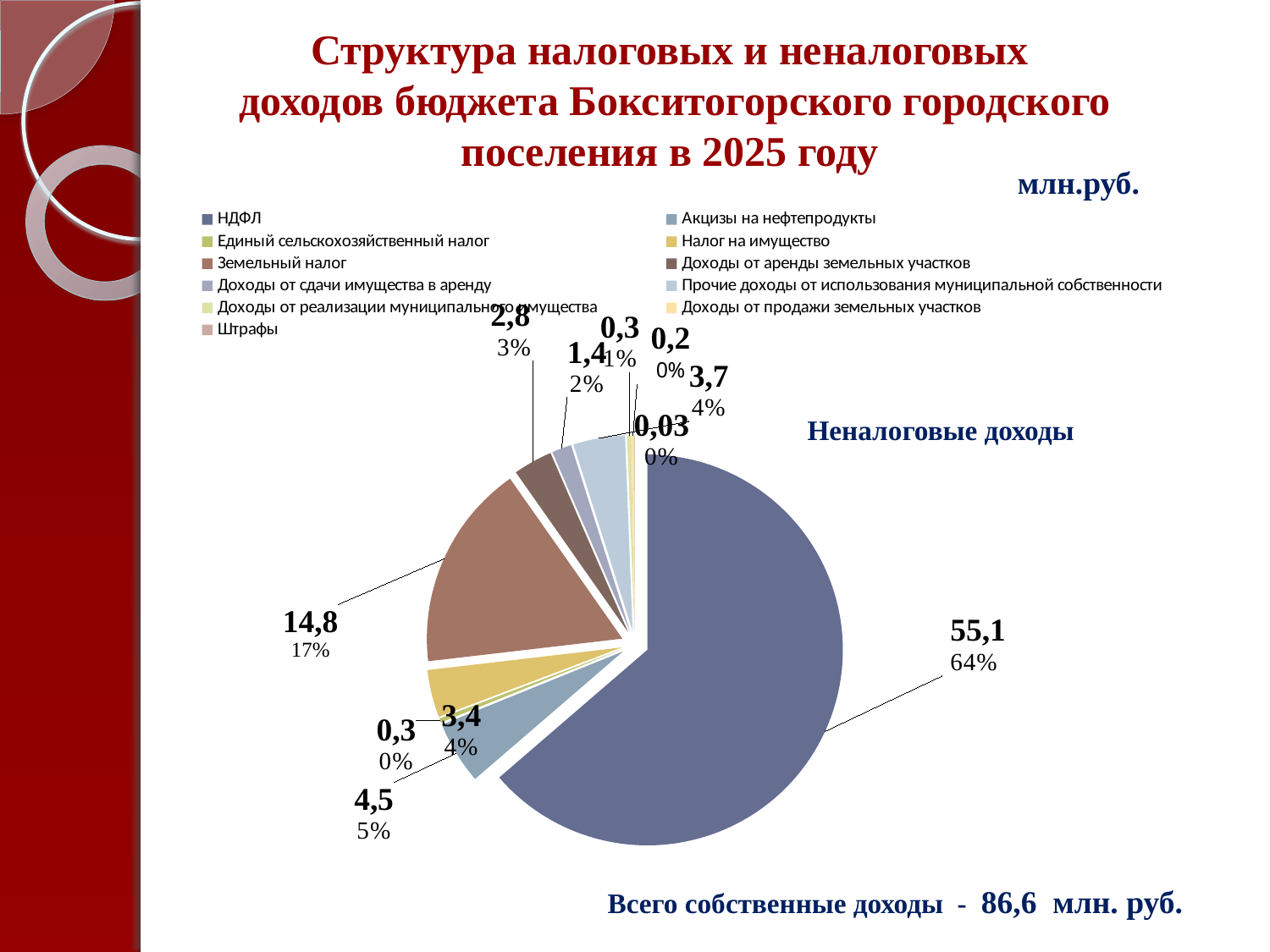
What share of the pie does НДФЛ account for? 64% What is the value shown for НДФЛ? 55,1 What share of the pie does Земельный налог account for? 17% How many entries does the chart legend list? 11 Which is larger: the slice labelled 14,8 or the slice labelled 4,5? 14,8 What kind of chart is shown on the slide? pie chart What unit of measurement is indicated for the chart values? млн.руб. What is the difference between the values for НДФЛ (55,1) and Земельный налог (14,8)? 40,3 What total of own revenues is stated below the chart? 86,6 млн. руб. Which category has the largest slice of the pie? НДФЛ What is the value shown for Земельный налог? 14,8 What is the smallest data label value shown on the pie chart? 0,03